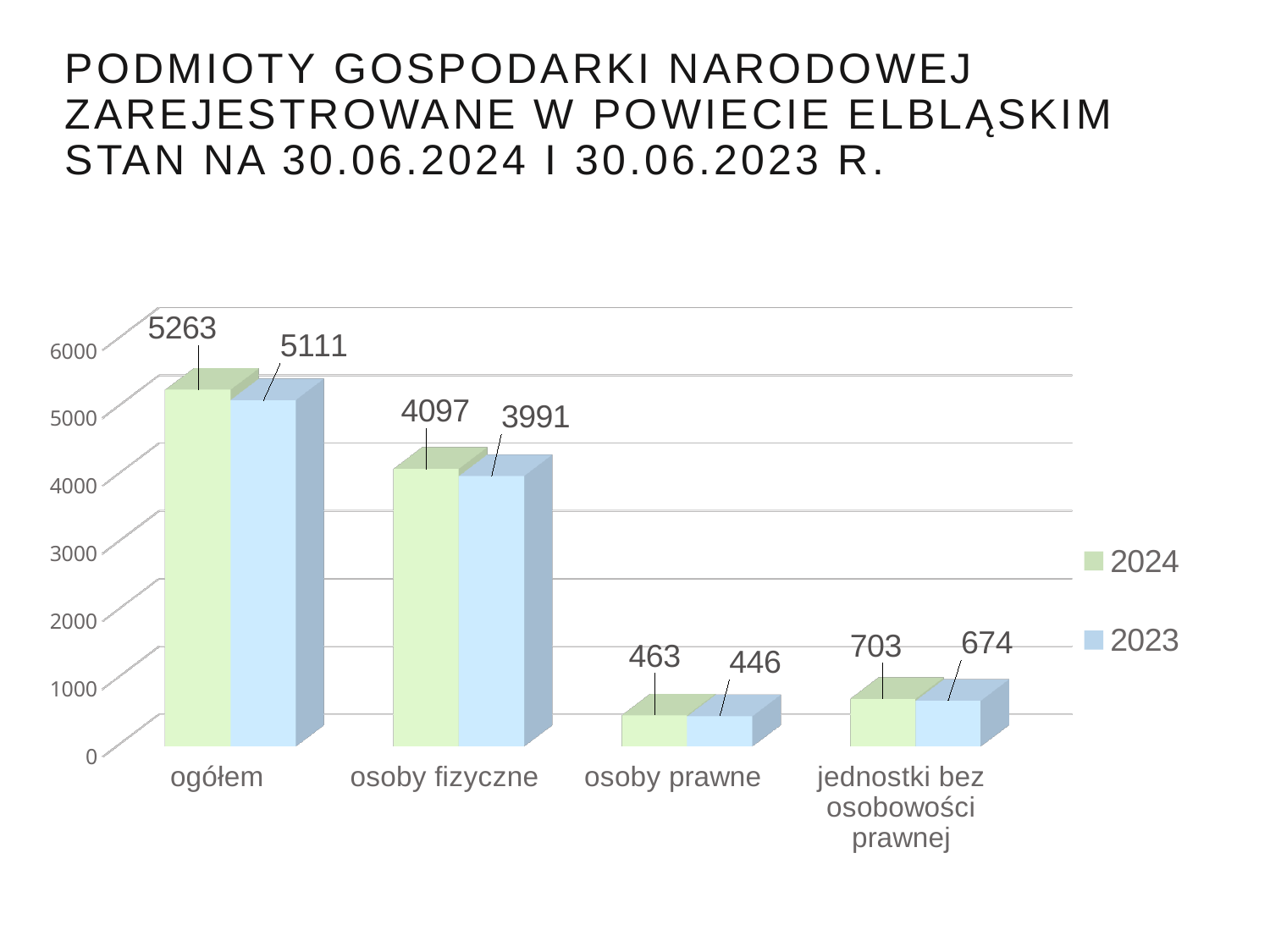
What is the difference between the 2024 and 2023 values for ogółem? 152 What is the value for osoby prawne in the 2024 series? 463 Which is larger for jednostki bez osobowości prawnej: the 2024 value or the 2023 value? 2024 How many categories are shown on the x axis? 4 What is the value for osoby fizyczne in the 2023 series? 3991 Which category has the highest value in the 2024 series? ogółem What is the value for jednostki bez osobowości prawnej in the 2023 series? 674 What is the value for ogółem in the 2024 series? 5263 What kind of chart is shown on the slide? bar chart What is the difference between the 2024 and 2023 values for osoby fizyczne? 106 Which category has the lowest value in the 2023 series? osoby prawne How many series does the legend list? 2